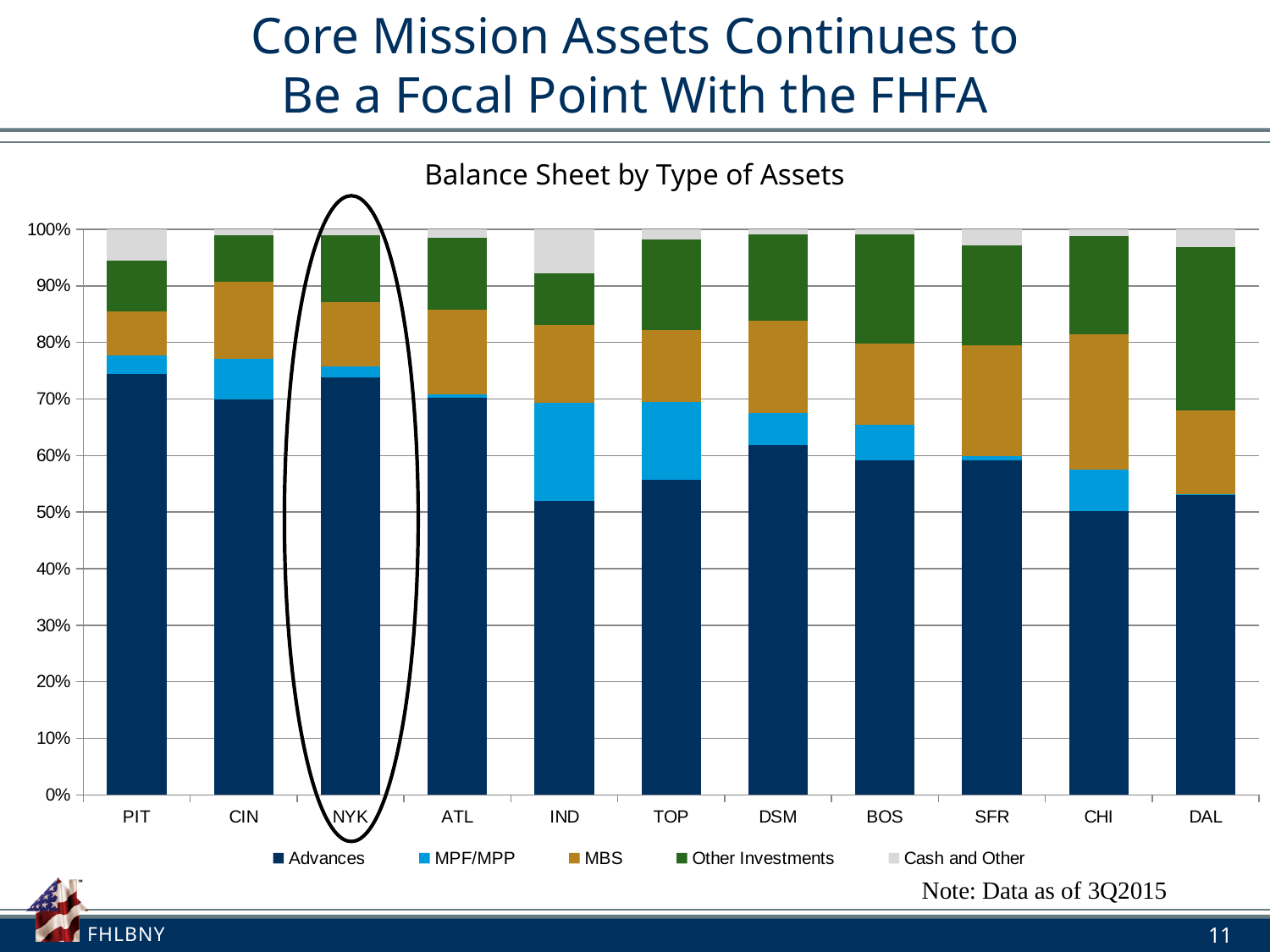
Is the Advances share for BOS greater or less than 50%? greater Is the Advances share for CHI greater or less than 60%? less Is the Advances share for IND greater or less than 60%? less Which category on the x axis is circled on the slide? NYK How many series does the chart's legend list? 5 What is the title of the chart? Balance Sheet by Type of Assets Which has the larger Other Investments share, DAL or PIT? DAL What kind of chart is shown on the slide? Stacked bar chart Which has the larger Advances share, PIT or IND? PIT How many banks (categories) are shown along the x axis of the chart? 11 Which bank has the largest Other Investments share? DAL